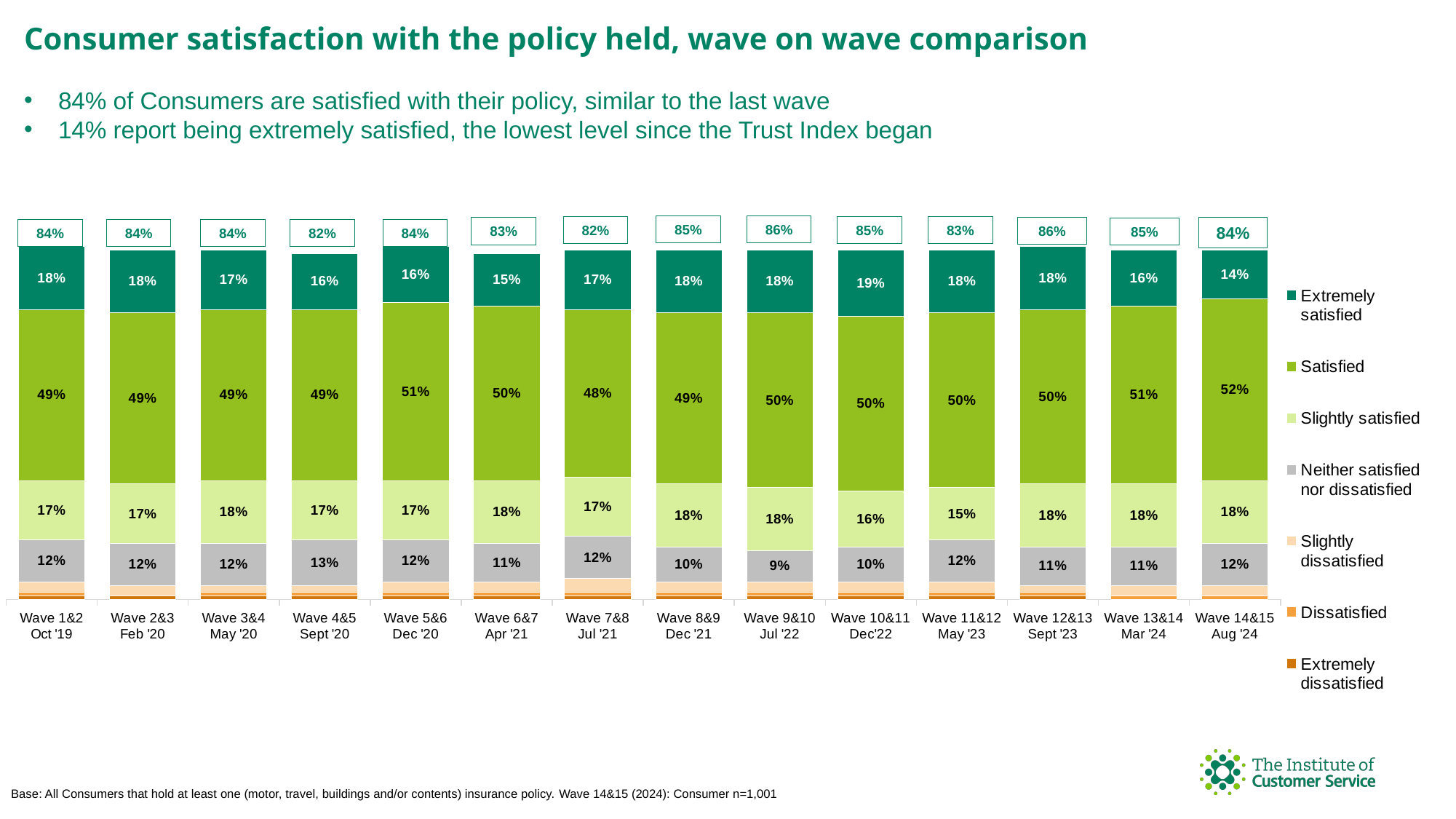
What is the Neither satisfied nor dissatisfied value for Wave 9&10 Jul '22? 9% Which wave has the lowest Extremely satisfied percentage? Wave 14&15 Aug '24 Which wave has the highest Extremely satisfied percentage? Wave 10&11 Dec'22 What kind of chart is shown on the slide? Stacked bar chart How many waves (bars) are shown in the chart? 14 Which wave has the highest Satisfied percentage? Wave 14&15 Aug '24 Which is larger, the Slightly satisfied value for Wave 11&12 May '23 or for Wave 12&13 Sept '23? Wave 12&13 Sept '23 What is the boxed overall satisfaction figure shown above the Wave 12&13 Sept '23 bar? 86% What percentage of consumers were extremely satisfied in Wave 14&15 Aug '24? 14% What is the difference between the Extremely satisfied values for Wave 1&2 Oct '19 and Wave 14&15 Aug '24? 4% What is the Satisfied value for Wave 5&6 Dec '20? 51% How many series does the legend list? 7